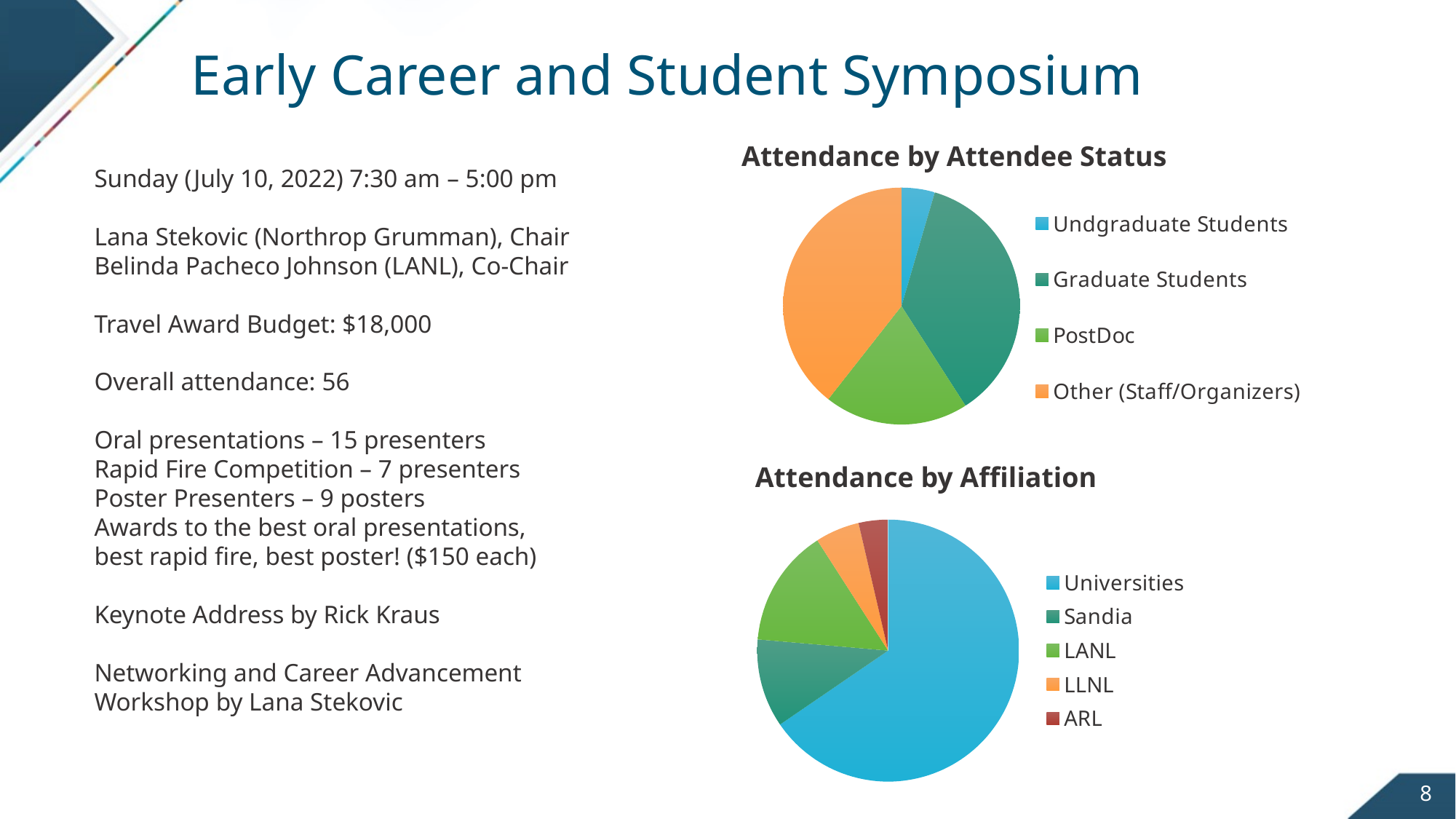
In the "Attendance by Affiliation" chart, which slice is larger: Universities or Sandia? Universities In the "Attendance by Attendee Status" chart, which category has the smallest slice? Undgraduate Students In the "Attendance by Attendee Status" chart, which slice is larger: Graduate Students or PostDoc? Graduate Students What kind of chart is the "Attendance by Affiliation" chart? Pie chart In the "Attendance by Attendee Status" chart, what colour is the PostDoc slice? Green In the "Attendance by Affiliation" chart, which affiliation has the largest slice? Universities In the "Attendance by Attendee Status" chart, how many categories are shown? 4 What is the title of the lower pie chart on the slide? Attendance by Affiliation In the "Attendance by Affiliation" chart, how many categories are shown? 5 In the "Attendance by Affiliation" chart, which affiliation has the smallest slice? ARL What kind of chart is the "Attendance by Attendee Status" chart? Pie chart In the "Attendance by Attendee Status" chart, which category has the largest slice? Other (Staff/Organizers)